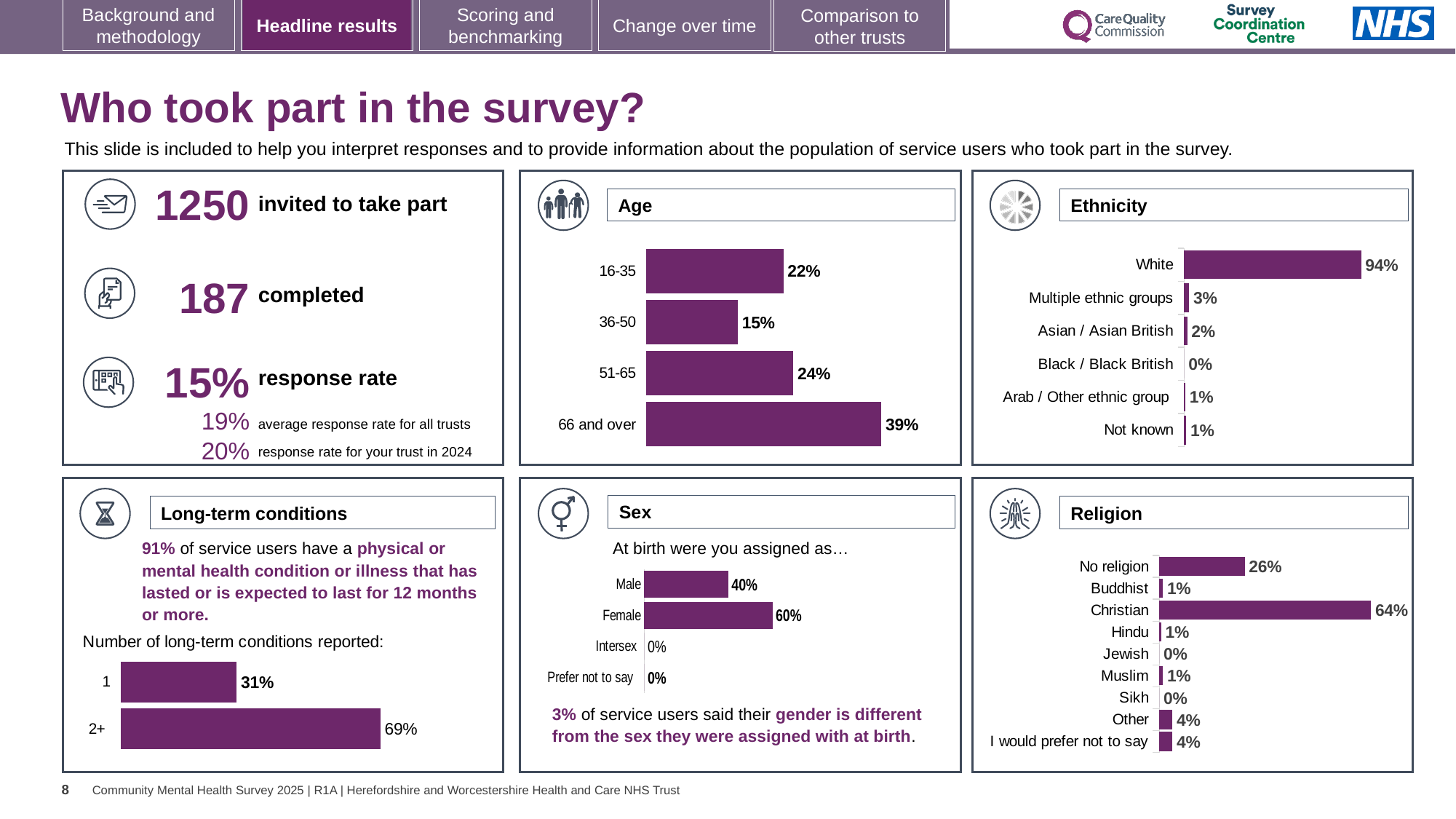
In the Ethnicity chart, what percentage of respondents were White? 94% How many categories are shown in the Ethnicity chart? 6 In the Religion chart, which category has the highest percentage? Christian In the Ethnicity chart, which is larger: Multiple ethnic groups or Asian / Asian British? Multiple ethnic groups What type of chart is used in the Age panel? Bar chart In the Age chart, which age group has the lowest percentage? 36-50 In the Religion chart, what percentage of respondents reported No religion? 26% In the Sex chart, what percentage of respondents were assigned Female at birth? 60% In the Sex chart, what is the difference between the Female and Male percentages? 20% In the Long-term conditions chart, what percentage of respondents reported 2+ long-term conditions? 69% In the Age chart, what percentage of respondents were aged 66 and over? 39% In the Age chart, what is the difference between the 51-65 and 16-35 percentages? 2%